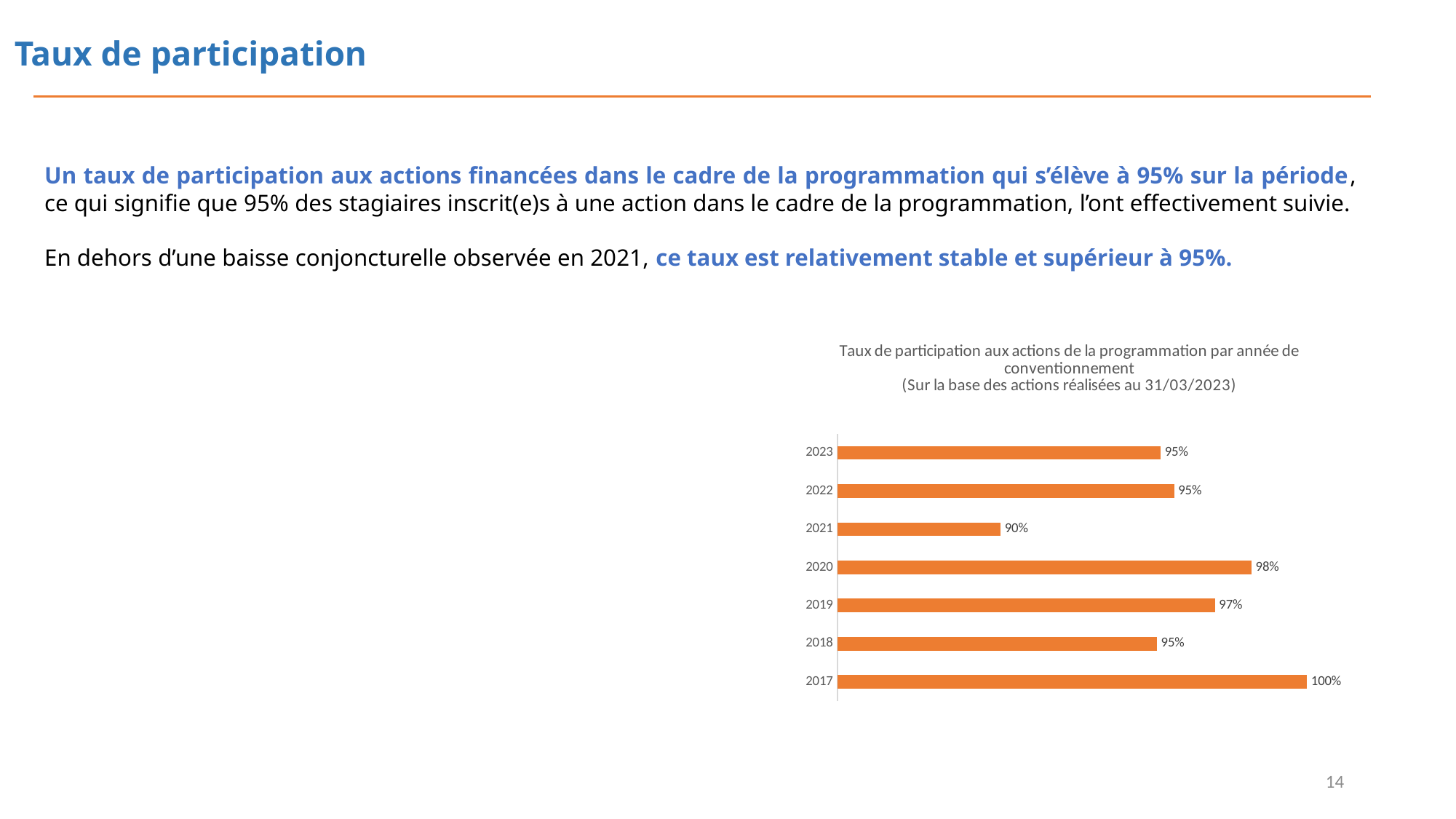
What is the difference between the participation rate in 2017 and in 2021? 10% What is the participation rate for 2021? 90% What is the participation rate for 2019? 97% Which year has the highest participation rate? 2017 What colour are the bars in the chart? Orange What is the participation rate for 2017? 100% What kind of chart is shown on the slide? Bar chart Which year has the lowest participation rate? 2021 What is the participation rate for 2020? 98% Which year has a higher participation rate, 2020 or 2021? 2020 How many years are shown in the chart? 7 What is the difference between the participation rate in 2020 and in 2019? 1%